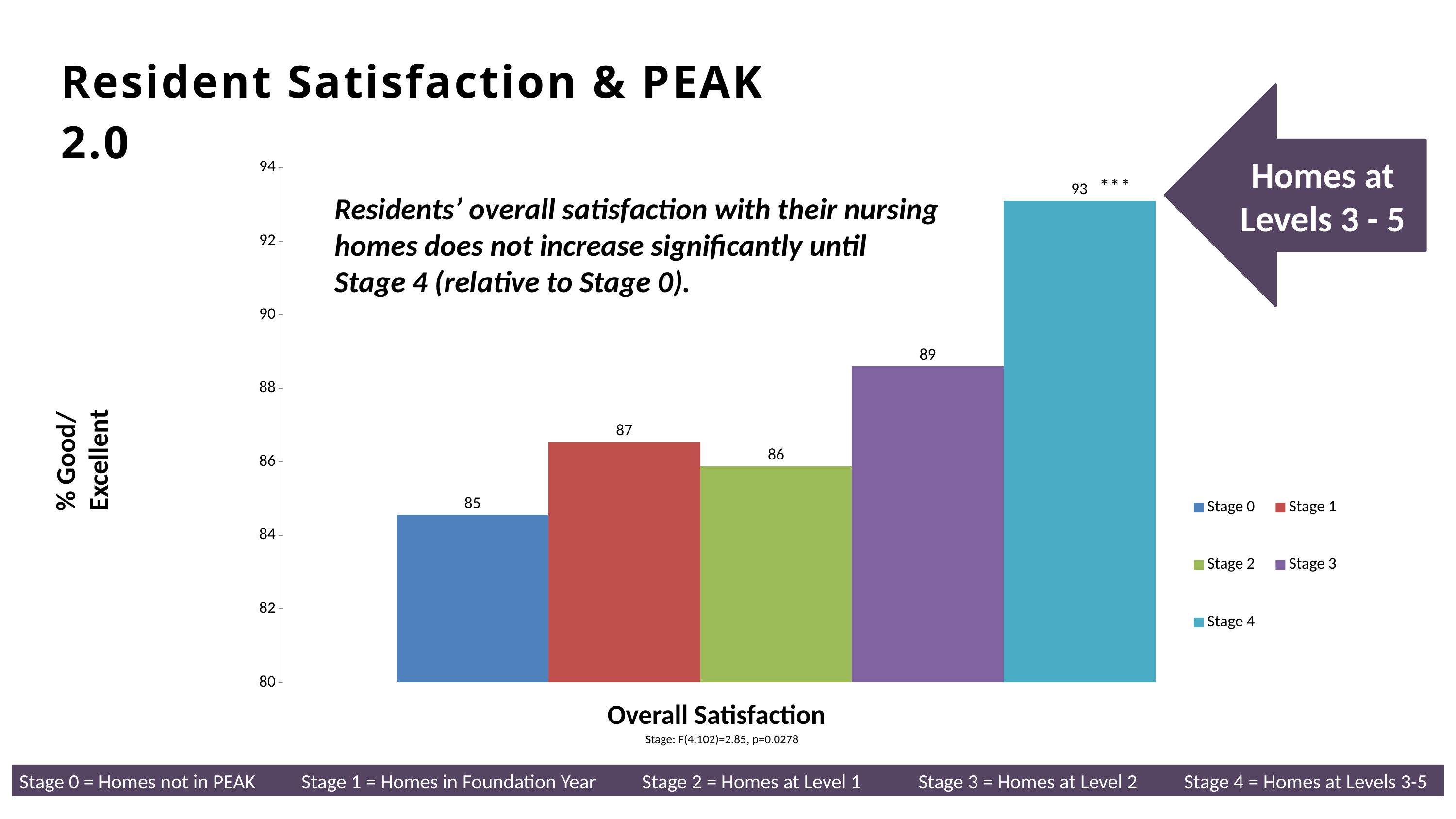
What is the value for Stage 4? 93 How many series does the legend list? 5 Which stage has the highest overall satisfaction? Stage 4 Which stage has the lowest overall satisfaction? Stage 0 What kind of chart is shown? bar chart Which is larger, the value for Stage 1 or the value for Stage 2? Stage 1 What is the difference between the values for Stage 4 and Stage 0? 8 What colour is the bar for Stage 4? teal/light blue What is the y-axis label of the chart? % Good/ Excellent Is the value for Stage 3 greater or less than 88? greater What is the value for Stage 3? 89 What is the value for Stage 0? 85